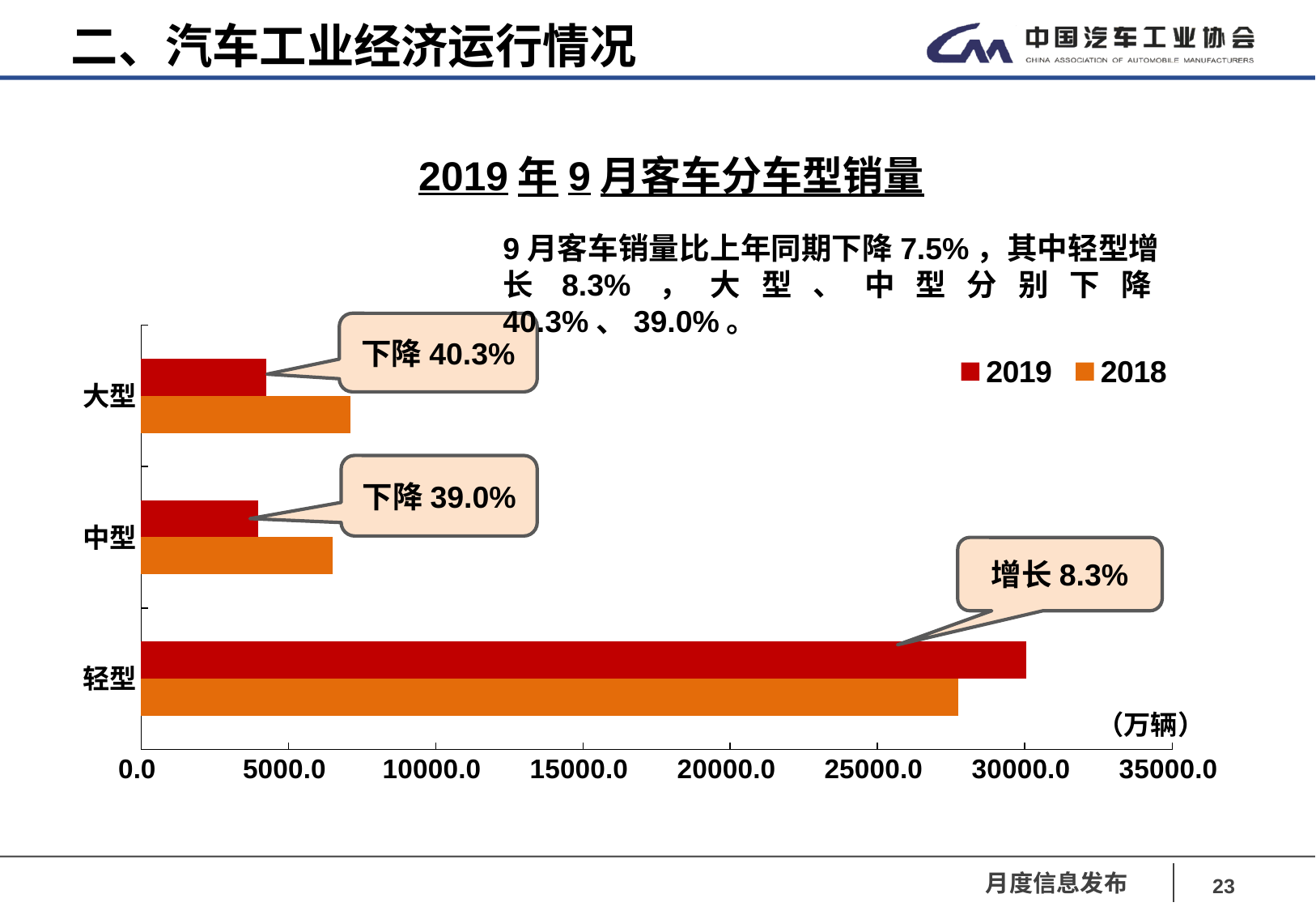
Is the 2019 value for 轻型 greater or less than 25000.0? greater What is the title of the chart? 2019 年 9 月客车分车型销量 Which category has the highest 2018 value? 轻型 Is the 2019 value for 大型 greater or less than 5000.0? less Which category has the highest 2019 value? 轻型 How many series does the legend list? 2 How many categories are shown on the chart? 3 For 大型, which is larger, the 2019 value or the 2018 value? 2018 Is the 2018 value for 中型 greater or less than 10000.0? less For 轻型, which is larger, the 2019 value or the 2018 value? 2019 What kind of chart is shown on the slide? bar chart What year-on-year change does the callout show for 中型? 下降 39.0%